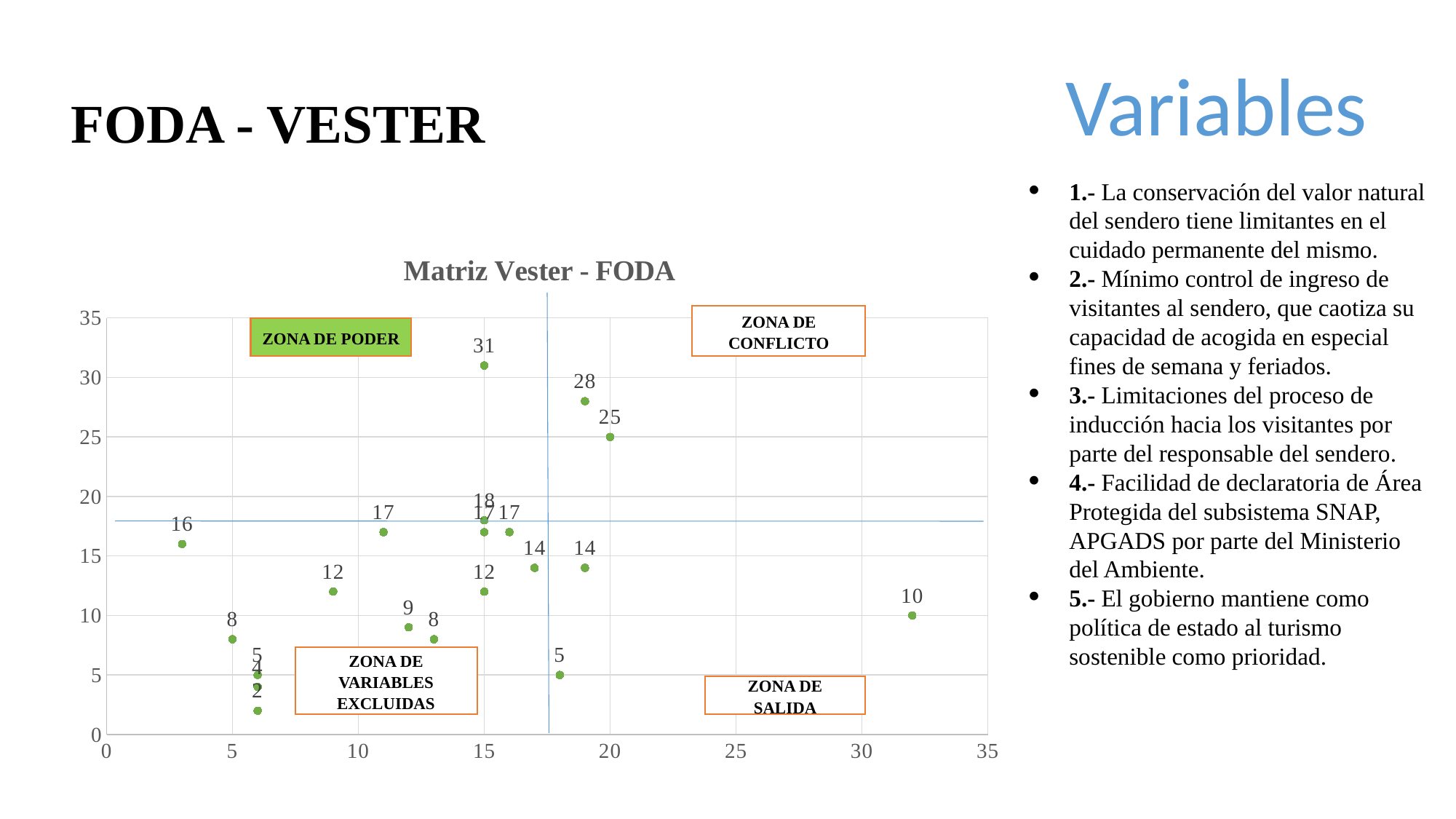
What is the maximum value shown on the vertical axis? 35 What kind of chart is shown on the slide? Scatter chart What is the difference between the highest labelled point (31) and the point labelled 28? 3 What is the labelled value of the point plotted at x = 3? 16 Which is larger: the point labelled 28 at x = 19 or the point labelled 25 at x = 20? 28 What is the title of the chart? Matriz Vester - FODA Is the value of the point plotted at x = 32 greater or less than 15? less What is the lowest data label value shown on the chart? 2 What is the highest data label value shown on the chart? 31 How many data points are plotted on the chart? 20 What is the labelled value of the point plotted at x = 32? 10 Is the value of the point plotted at x = 15 with the highest label greater or less than 30? greater